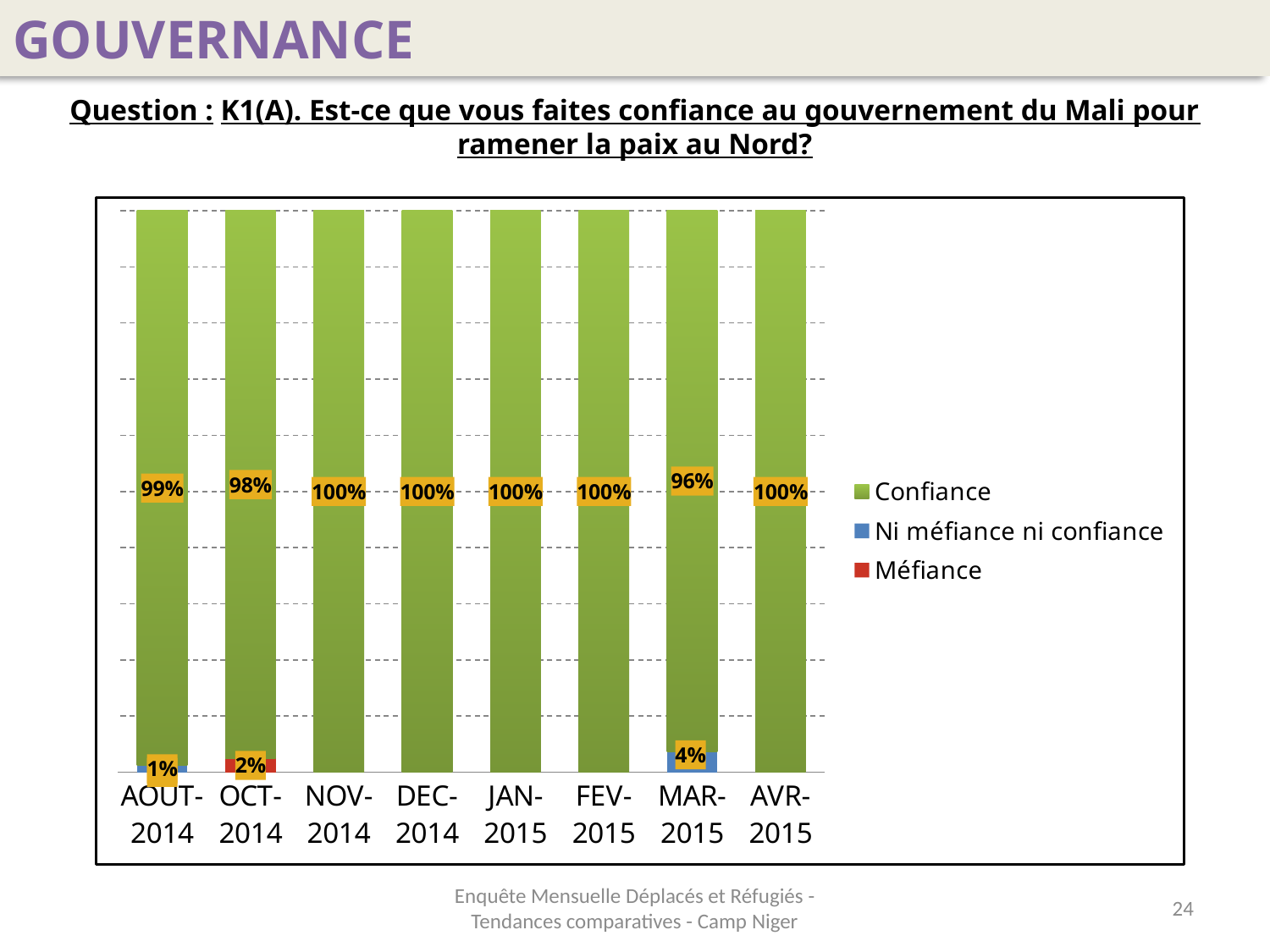
What is the Confiance value for OCT-2014? 98% What is the Confiance value for AOUT-2014? 99% What is the Ni méfiance ni confiance value for MAR-2015? 4% What type of chart is shown on the slide? stacked bar chart Which series is shown in green in the legend? Confiance What is the Confiance value for MAR-2015? 96% What is the difference between the Confiance values for OCT-2014 and MAR-2015? 2% How many series does the legend list? 3 How many months are shown on the x axis? 8 Which is larger, the Confiance value for AOUT-2014 or for MAR-2015? AOUT-2014 Which month has the lowest Confiance value? MAR-2015 What is the Confiance value for AVR-2015? 100%